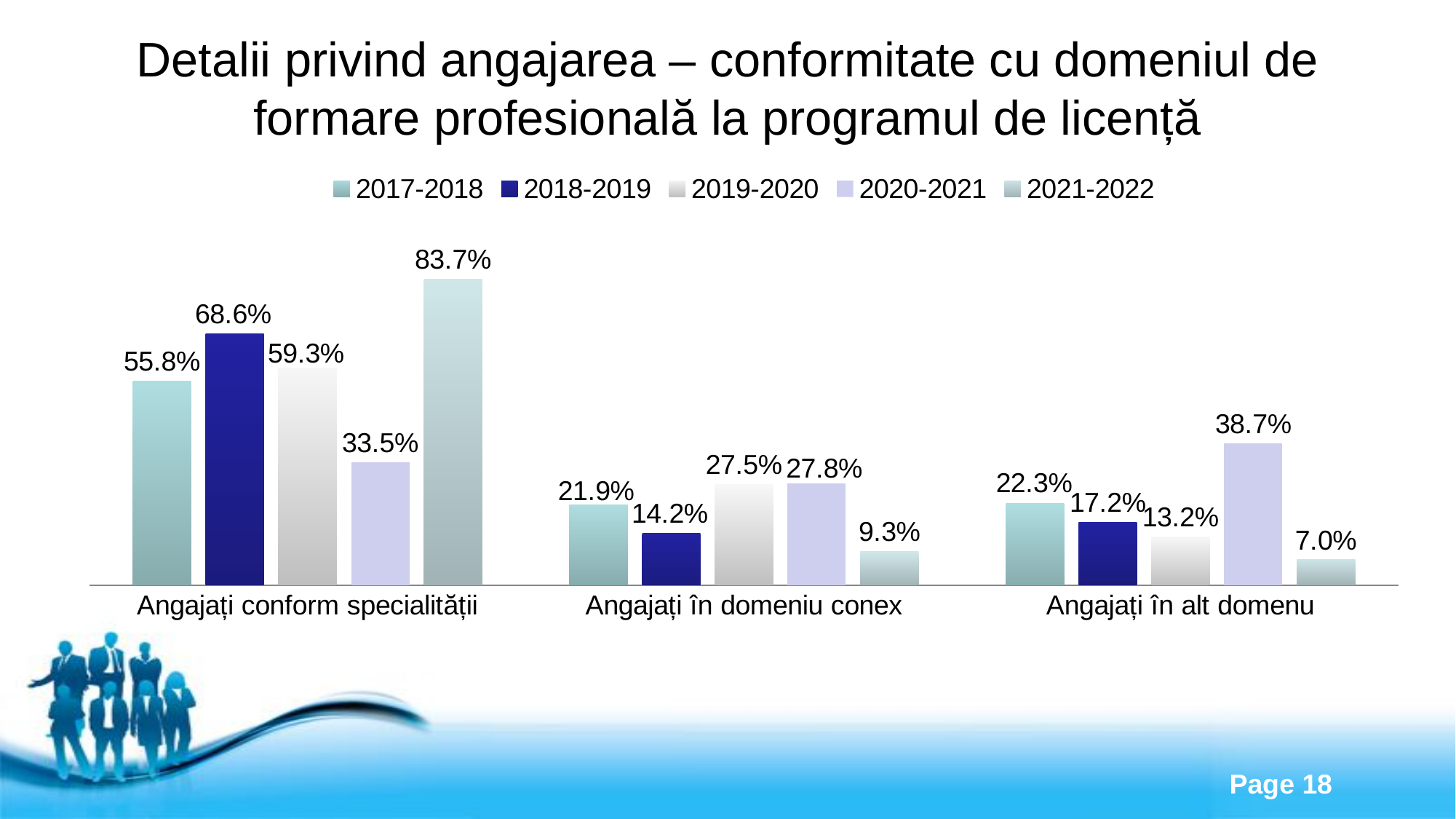
What is the value for 2018-2019 in the "Angajați în domeniu conex" category? 14.2% What is the value for 2021-2022 in the "Angajați conform specialității" category? 83.7% Which series is shown in dark blue in the legend? 2018-2019 What is the difference between the 2021-2022 and 2017-2018 values in the "Angajați conform specialității" category? 27.9% Which series has the highest value in the "Angajați conform specialității" category? 2021-2022 Which series has the lowest value in the "Angajați în alt domenu" category? 2021-2022 Which is larger in the "Angajați în domeniu conex" category: the 2017-2018 value or the 2019-2020 value? 2019-2020 How many categories are shown on the x axis? 3 How many series does the legend list? 5 What kind of chart is shown on the slide? Bar chart What is the value for 2020-2021 in the "Angajați în alt domenu" category? 38.7% What is the difference between the 2020-2021 and 2021-2022 values in the "Angajați în alt domenu" category? 31.7%